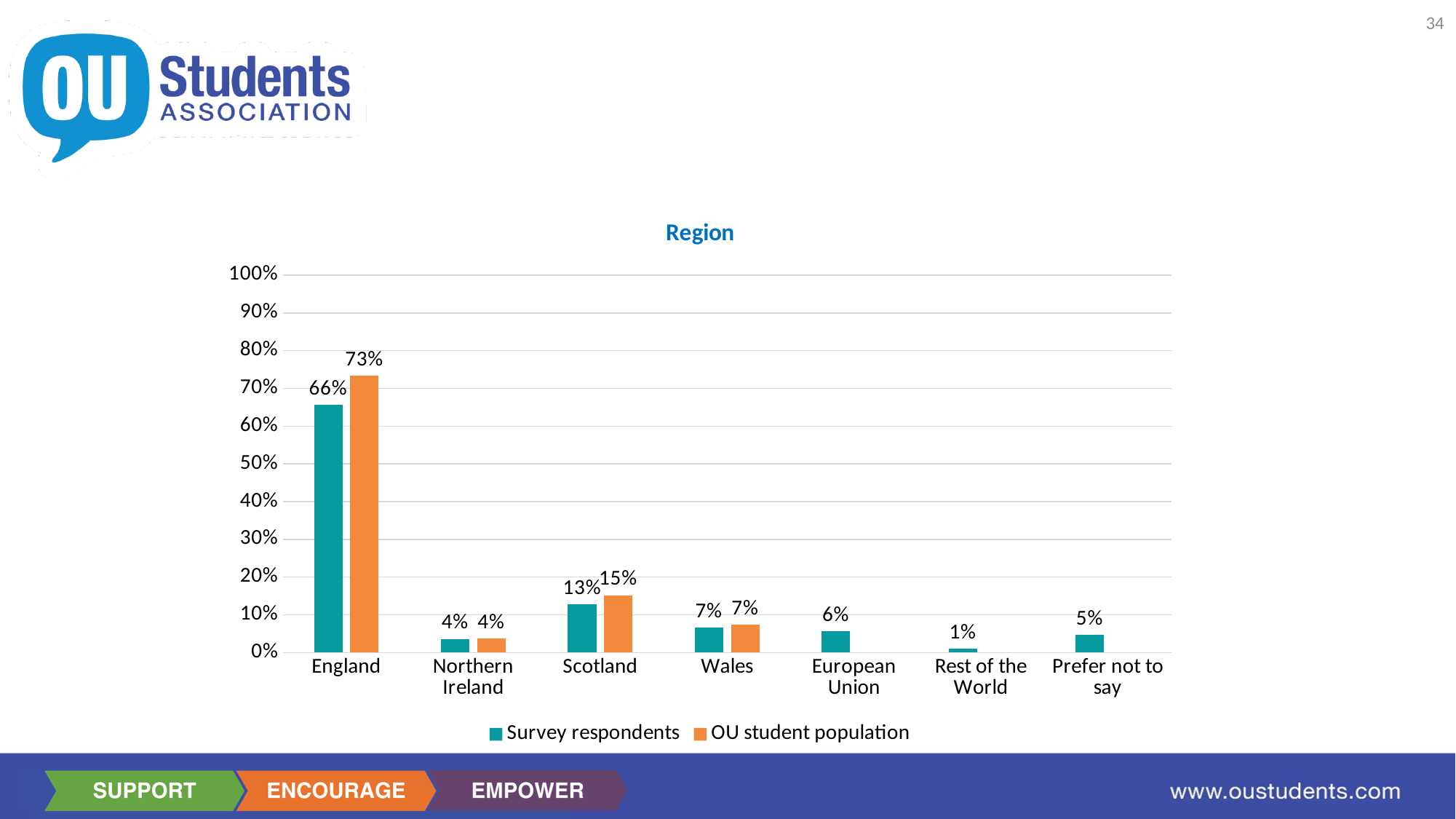
Which region has the lowest Survey respondents value? Rest of the World How many series does the legend list? 2 What is the Survey respondents value for Rest of the World? 1% What is the title of the chart? Region Is the Survey respondents value for England greater or less than 50%? greater Which region has the highest Survey respondents value? England How many regions are shown on the x axis? 7 What kind of chart is shown? bar chart What is the OU student population value for Scotland? 15% What is the Survey respondents value for England? 66% For Scotland, which is larger: Survey respondents or OU student population? OU student population What is the difference between the OU student population and Survey respondents values for England? 7%